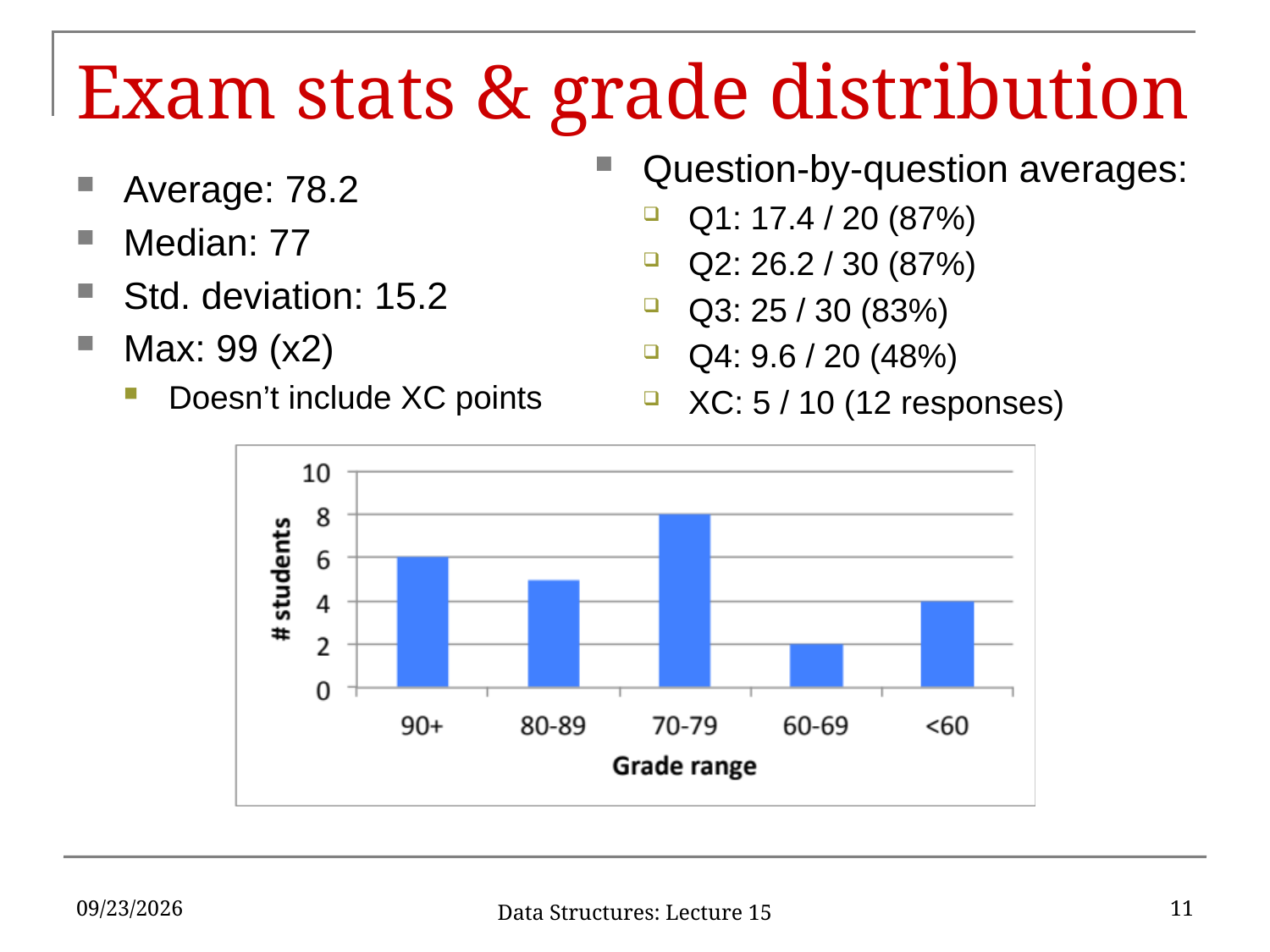
How many students are in the 90+ grade range? 6 How many grade ranges are shown on the x axis? 5 How many students are in the <60 grade range? 4 Which grade range has more students, 90+ or <60? 90+ Is the number of students in the 80-89 range greater or less than 4? greater What kind of chart is shown on the slide? bar chart Which grade range has the fewest students? 60-69 What is the label of the vertical axis of the chart? # students Which grade range has the most students? 70-79 How many students are in the 60-69 grade range? 2 How many students are in the 70-79 grade range? 8 How many more students are in the 70-79 range than in the 60-69 range? 6